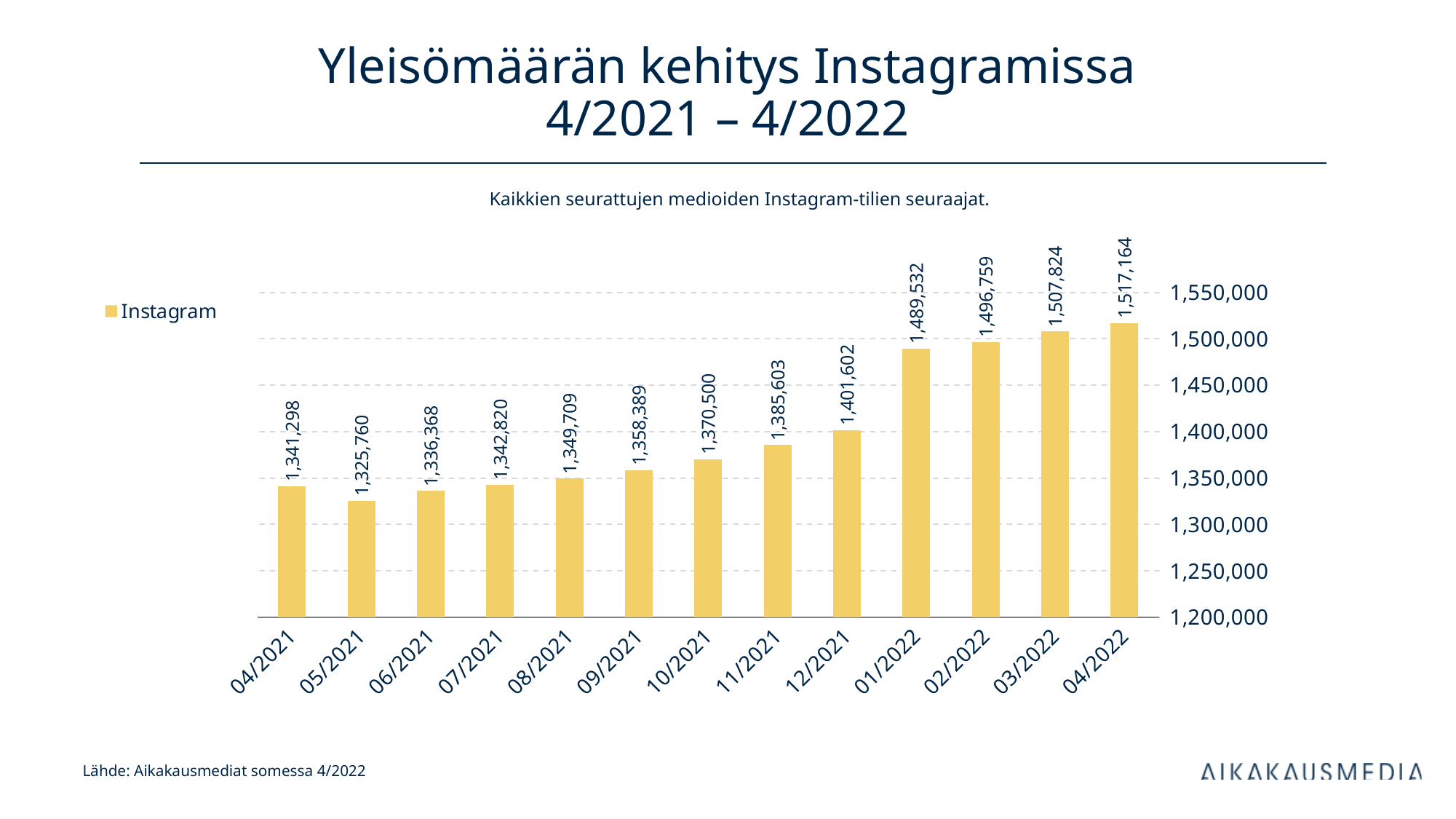
Is the value for 03/2022 greater or less than 1,500,000? greater Which is larger, the value for 12/2021 or the value for 11/2021? 12/2021 How many months are shown on the x axis? 13 What is the value for 01/2022? 1,489,532 What is the value for 10/2021? 1,370,500 Which month has the highest value? 04/2022 What kind of chart is shown on the slide? bar chart Do the values generally rise or fall from 05/2021 to 04/2022? rise Which month has the lowest value? 05/2021 What is the value for 04/2021? 1,341,298 What is the difference between the values for 04/2022 and 04/2021? 175,866 What is the difference between the values for 01/2022 and 12/2021? 87,930